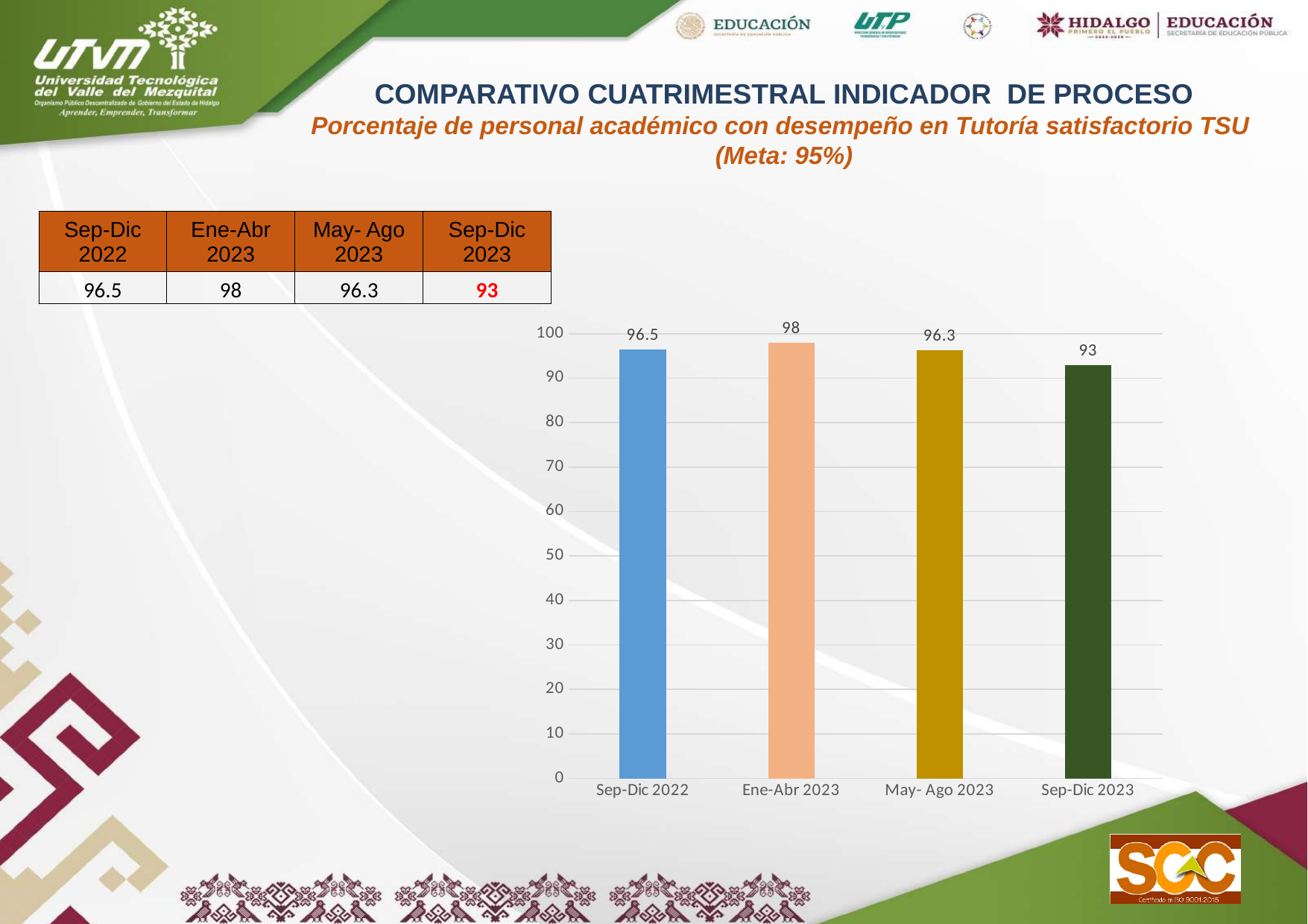
Which period has the highest value? Ene-Abr 2023 What is the difference between the values for Ene-Abr 2023 and Sep-Dic 2023? 5 Is the value for Sep-Dic 2023 greater or less than 90? greater What is the value for Sep-Dic 2023? 93 Do the values rise or fall from May- Ago 2023 to Sep-Dic 2023? fall What is the value for Sep-Dic 2022? 96.5 Which period has the lowest value? Sep-Dic 2023 What is the target (Meta) stated in the slide title? 95% What kind of chart is shown on the slide? bar chart Which is larger, the value for May- Ago 2023 or the value for Sep-Dic 2023? May- Ago 2023 How many periods are shown on the x axis of the chart? 4 What is the value for Ene-Abr 2023? 98